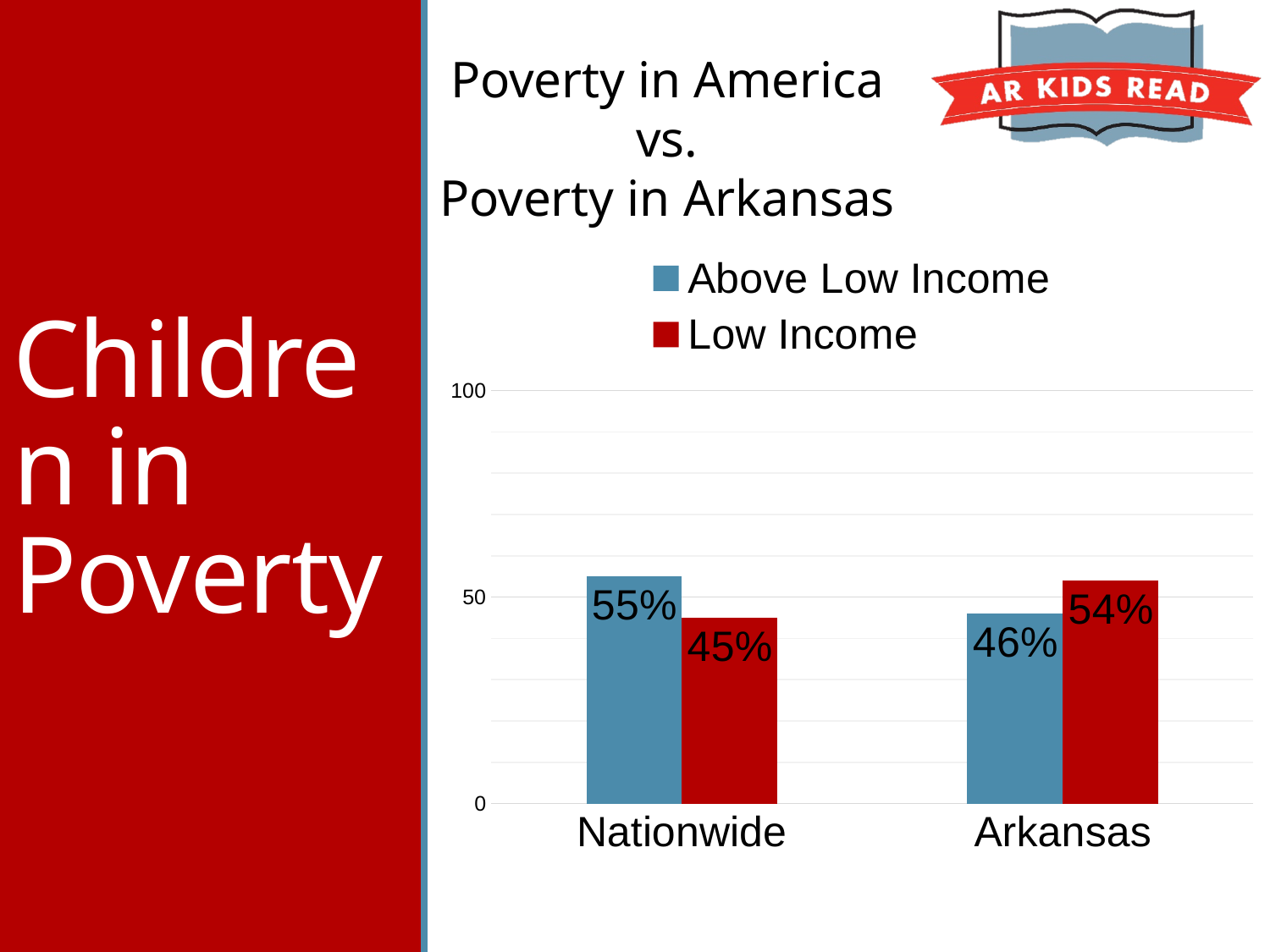
What is the difference between the Above Low Income and Low Income values for Nationwide? 10% How many series does the legend list? 2 What kind of chart is shown on the slide? Bar chart Which colour represents the Low Income series? Red What is the Above Low Income value for Arkansas? 46% What is the Low Income value for Nationwide? 45% How many categories are shown on the x axis? 2 What is the Low Income value for Arkansas? 54% What is the difference between the Low Income values for Arkansas and Nationwide? 9% What is the Above Low Income value for Nationwide? 55% Which category has the lowest Above Low Income value? Arkansas Which category has the higher Low Income value, Nationwide or Arkansas? Arkansas